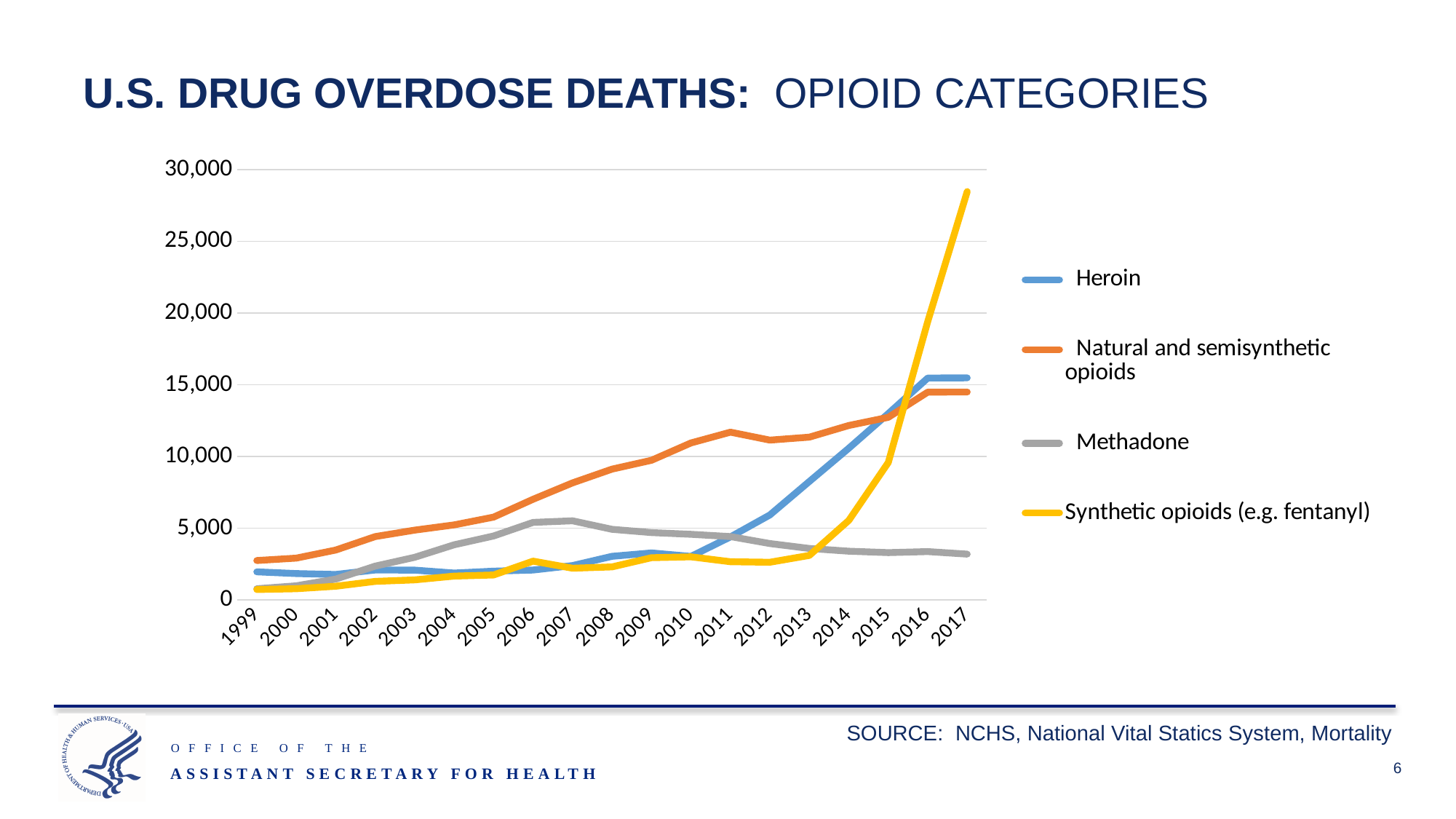
In 2011, which is larger: Heroin or Natural and semisynthetic opioids? Natural and semisynthetic opioids Is the value for Synthetic opioids (e.g. fentanyl) in 2017 greater or less than 25,000? greater Which series has the highest value in 2017? Synthetic opioids (e.g. fentanyl) How many years are plotted along the x axis? 19 Do the values for Synthetic opioids (e.g. fentanyl) rise or fall from 2013 to 2017? rise What is the title of the slide's chart? U.S. DRUG OVERDOSE DEATHS: OPIOID CATEGORIES What kind of chart is shown on the slide? line chart Is the value for Heroin in 2017 greater or less than 20,000? less Which series has the lowest value in 2017? Methadone How many series does the legend list? 4 Which series has the highest value in 2007? Natural and semisynthetic opioids Is the value for Natural and semisynthetic opioids in 2011 greater or less than 10,000? greater